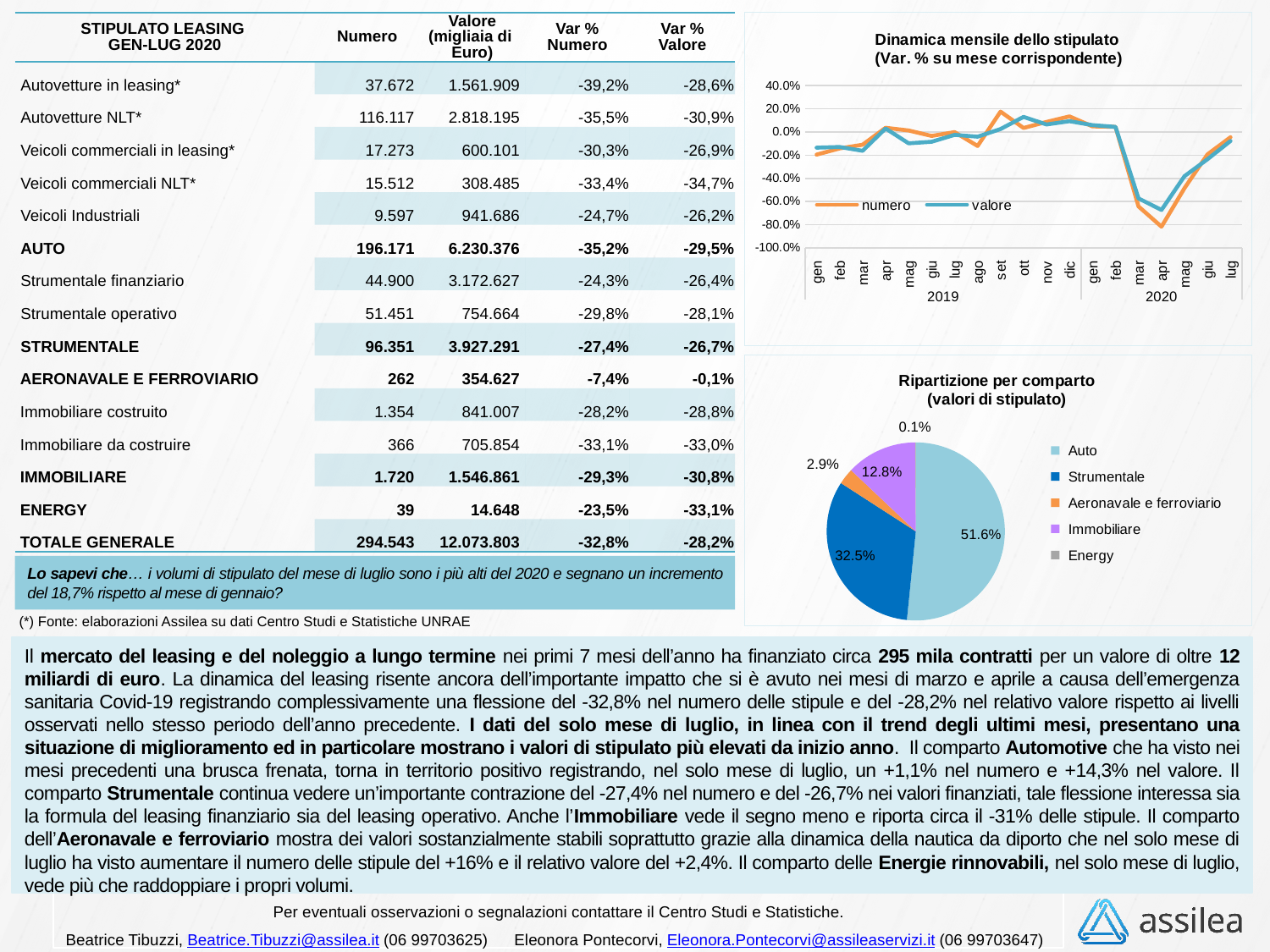
How many slices does the 'Ripartizione per comparto' pie chart have? 5 In the 'Dinamica mensile dello stipulato' chart, is the value of the 'numero' series for set 2019 greater or less than 0.0%? greater In the 'Dinamica mensile dello stipulato' chart, is the value of the 'numero' series for apr 2020 greater or less than -60.0%? less What kind of chart is the 'Dinamica mensile dello stipulato' chart? line chart In the 'Dinamica mensile dello stipulato' chart, which month shows the lowest value for the 'numero' series? apr 2020 How many series does the legend of the 'Dinamica mensile dello stipulato' chart list? 2 In the 'Ripartizione per comparto' pie chart, what share does Auto have? 51.6% In the 'Dinamica mensile dello stipulato' chart, is the value of the 'valore' series for lug 2020 greater or less than -20.0%? greater In the 'Ripartizione per comparto' pie chart, what share does Immobiliare have? 12.8% In the 'Ripartizione per comparto' pie chart, which comparto has the smallest share? Energy In the 'Ripartizione per comparto' pie chart, what is the difference between the Auto share and the Strumentale share? 19.1% What kind of chart is the 'Ripartizione per comparto' chart? pie chart